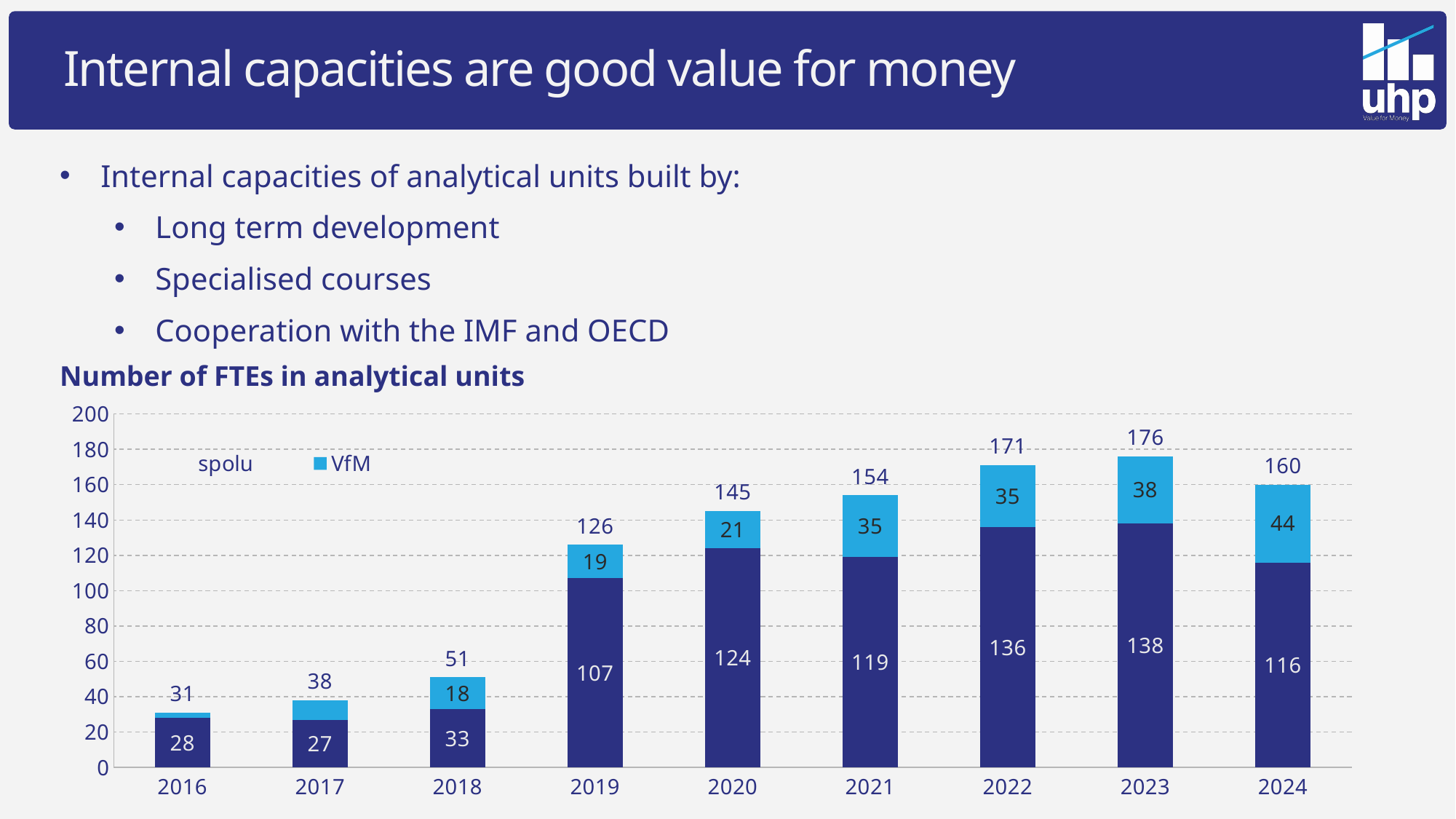
What kind of chart is shown on the slide? Stacked bar chart What is the value of the dark blue segment for 2019? 107 Do the total FTE values rise or fall from 2016 to 2023? Rise Which year has the highest total number of FTEs? 2023 Which year has the larger dark blue segment, 2020 or 2021? 2020 What is the title of the chart? Number of FTEs in analytical units Which year has the lowest total number of FTEs? 2016 How many series does the chart legend list? 2 What is the total number of FTEs in analytical units for 2023? 176 What is the difference between the total for 2023 and the total for 2024? 16 How many years are shown on the x axis of the chart? 9 What is the VfM value for 2024? 44